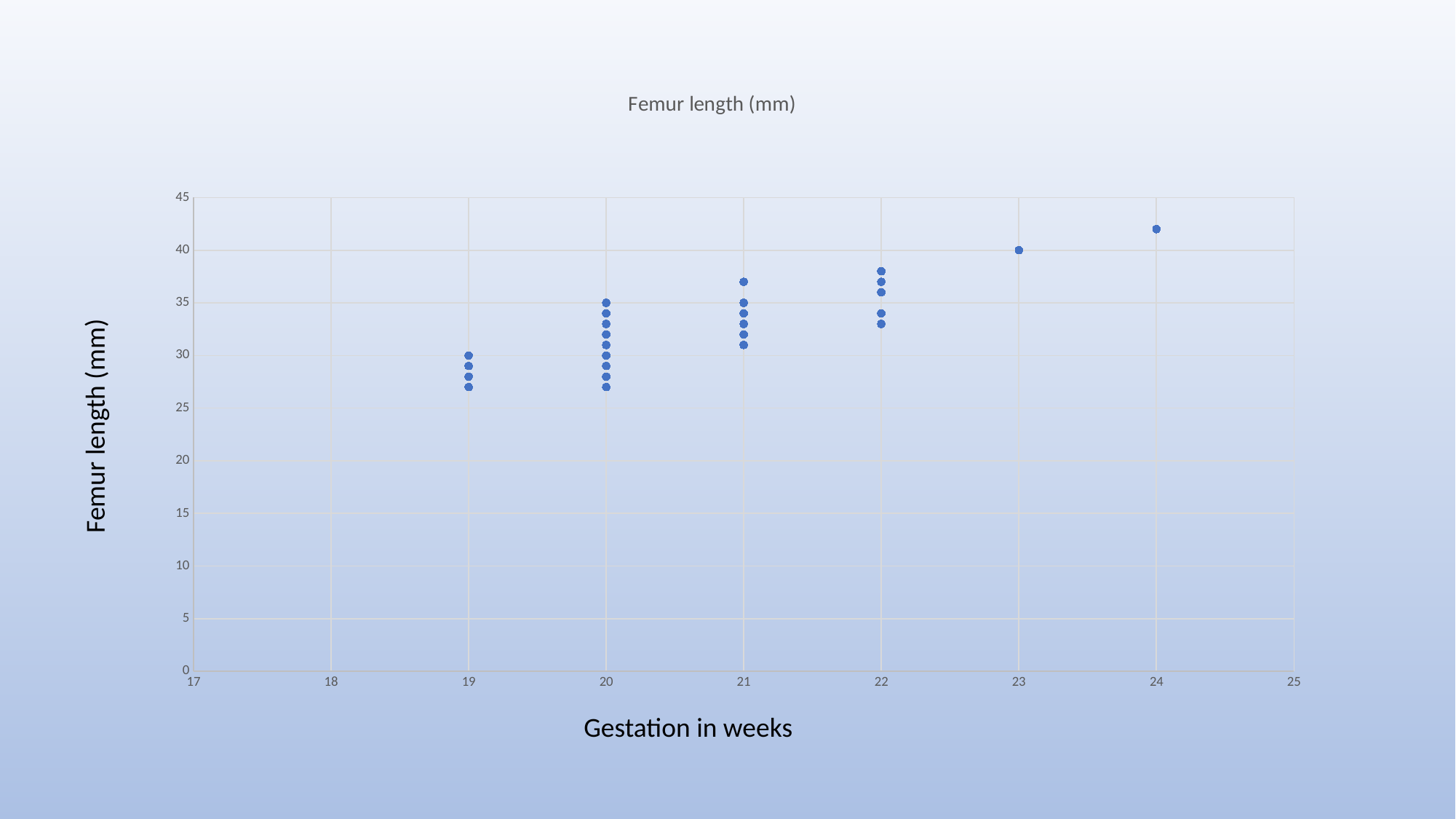
Do femur lengths generally rise or fall as gestation weeks increase? rise Is the femur length plotted at 24 weeks greater or less than 40? greater What is the femur length plotted at 23 weeks of gestation? 40 Is the highest femur length plotted at 22 weeks greater or less than 40? less What kind of chart is shown on the slide? scatter chart How many distinct gestation weeks have points plotted? 6 At which gestation week is the highest femur length plotted? 24 Which has the larger femur length: the point at 24 weeks or the point at 23 weeks? 24 weeks What is the label of the x axis? Gestation in weeks Is the lowest femur length plotted at 19 weeks greater or less than 25? greater What is the title of the chart? Femur length (mm)